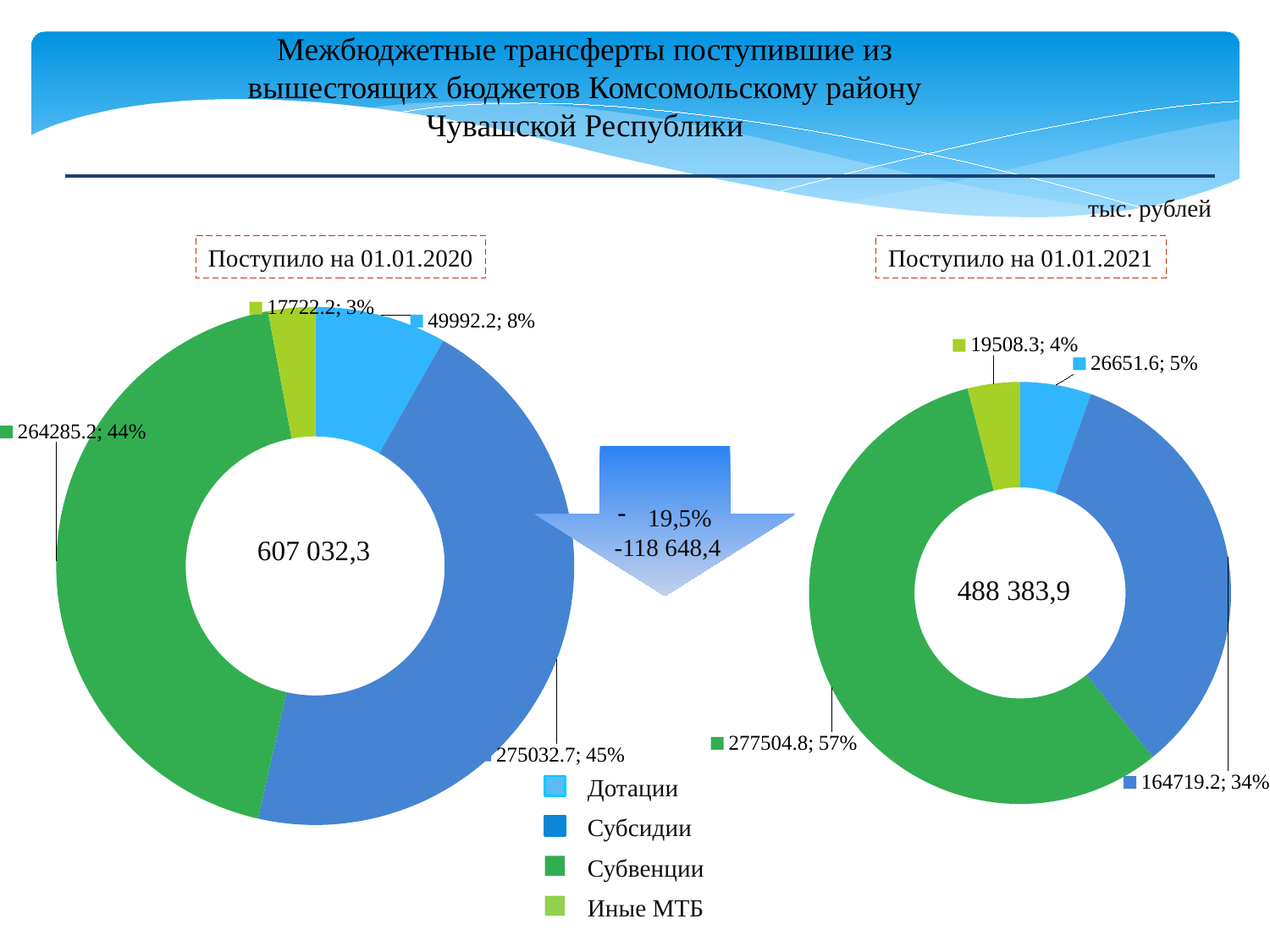
In the chart titled "Поступило на 01.01.2020", what value is shown for Дотации? 49992.2; 8% In the chart titled "Поступило на 01.01.2021", what value is shown for Субсидии? 164719.2; 34% In the chart titled "Поступило на 01.01.2021", which is larger: Субсидии or Дотации? Субсидии In the chart titled "Поступило на 01.01.2020", which category has the smallest share? Иные МТБ What type of chart is used on the slide? Doughnut (pie) chart How many categories does the legend list for the charts on the slide? 4 What total is shown in the centre of the chart titled "Поступило на 01.01.2020"? 607 032,3 In the chart titled "Поступило на 01.01.2021", what value is shown for Субвенции? 277504.8; 57% In the chart titled "Поступило на 01.01.2021", which category has the smallest share? Иные МТБ In the chart titled "Поступило на 01.01.2021", what share of the total do Дотации make up? 5% In the chart titled "Поступило на 01.01.2021", which category has the largest share? Субвенции In the chart titled "Поступило на 01.01.2020", what share of the total do Субвенции make up? 44%